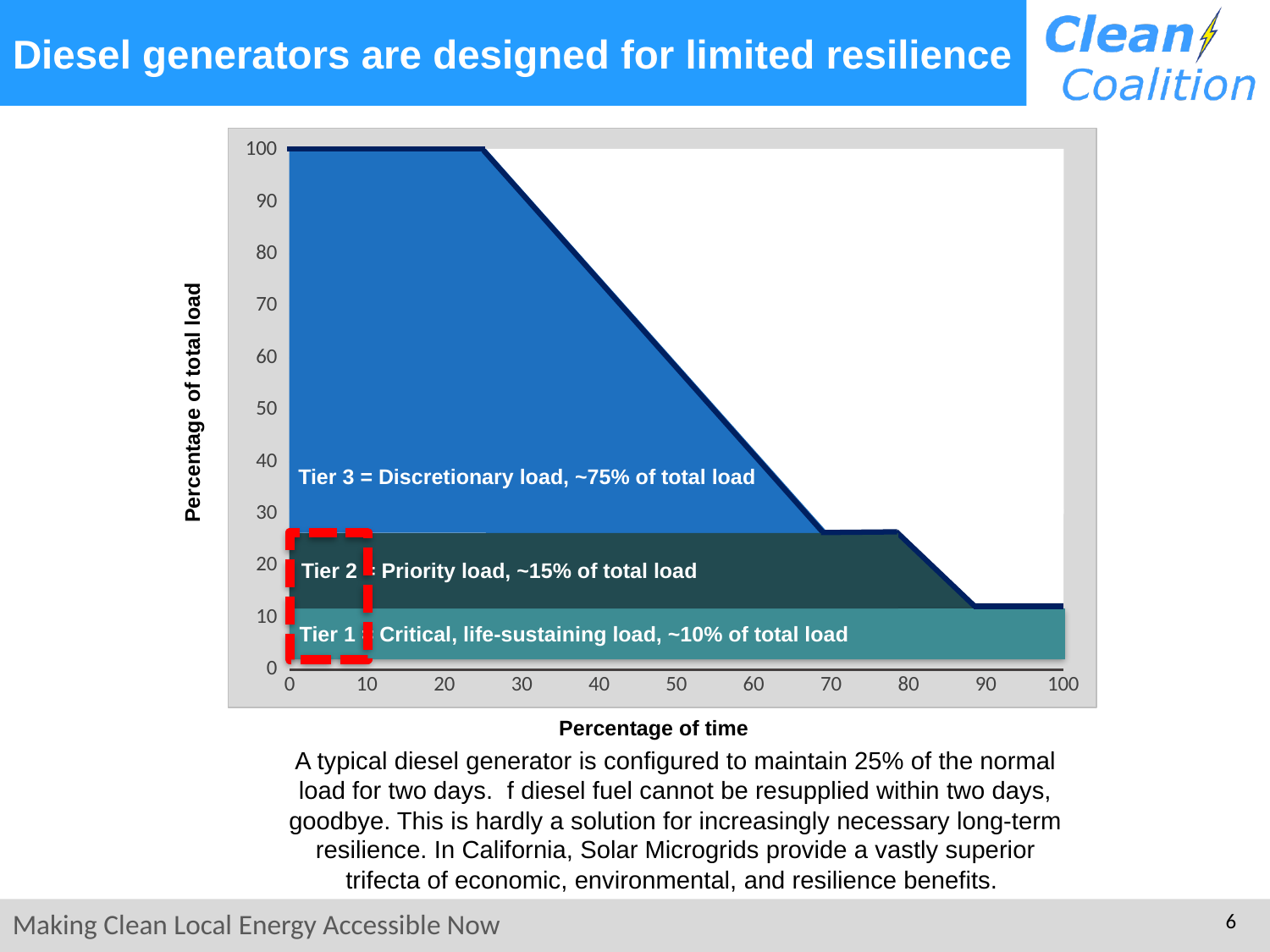
According to the chart label, Tier 3 (discretionary load) is what share of total load? ~75% What kind of chart is shown on the slide? area chart Which tier accounts for the largest share of total load? Tier 3 According to the chart label, Tier 1 (critical, life-sustaining load) is what share of total load? ~10% Which is larger, the share of total load for Tier 2 or for Tier 1? Tier 2 Is the percentage of total load at 50% of time greater or less than 50? greater According to the chart label, Tier 2 (priority load) is what share of total load? ~15% What is the title of the y axis? Percentage of total load Do the plotted values rise or fall as percentage of time increases? fall What is the title of the x axis? Percentage of time How many tiers of load are labelled on the chart? 3 Which tier accounts for the smallest share of total load? Tier 1